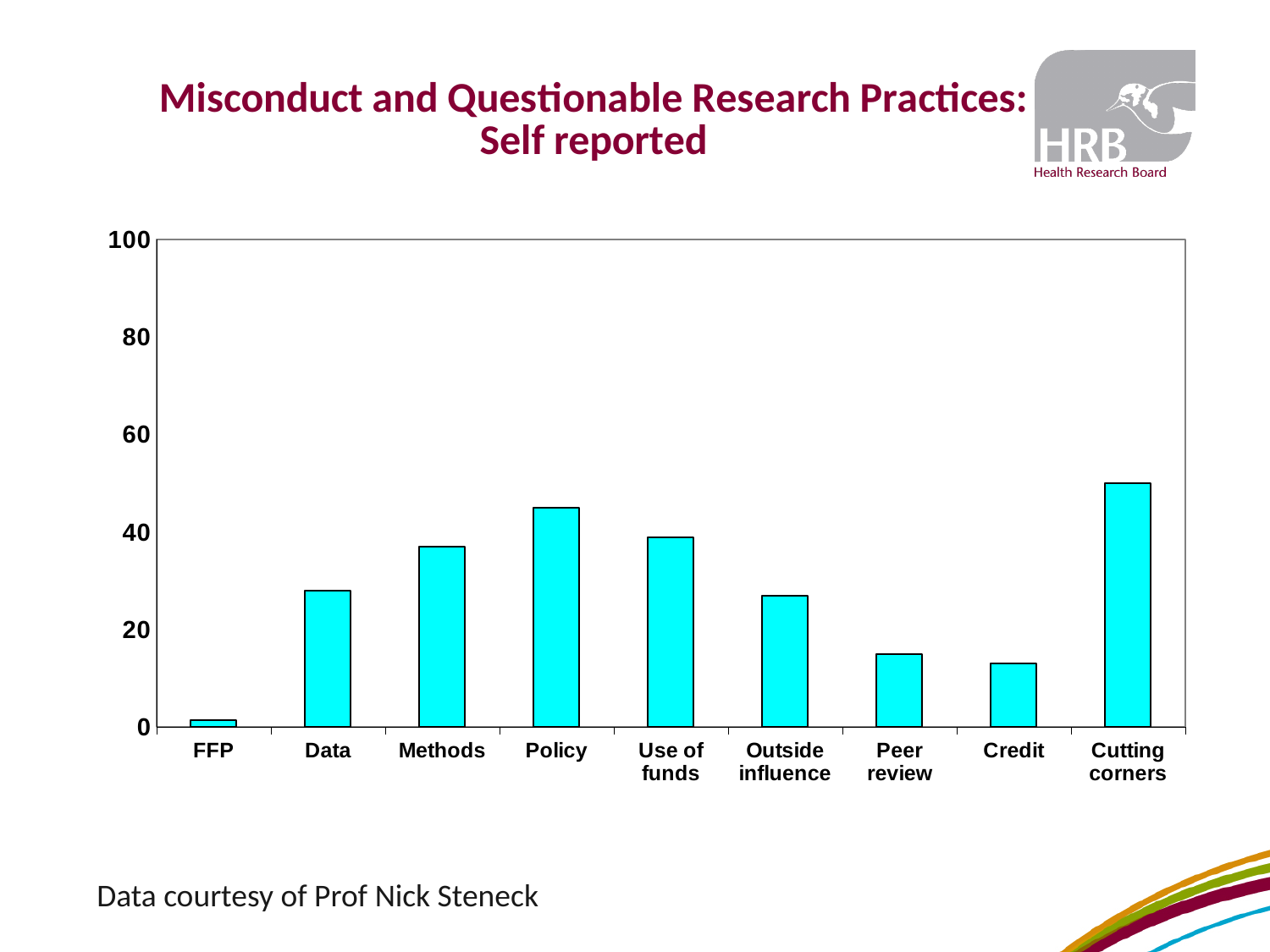
Is the value for Credit greater or less than 20? less What is the title of the slide containing the chart? Misconduct and Questionable Research Practices: Self reported Is the value for Data greater or less than 20? greater Is the value for Policy greater or less than 40? greater What is the highest value shown on the y axis? 100 Which is larger, the value for Policy or the value for Data? Policy Which category has the highest bar? Cutting corners Which is larger, the value for Methods or the value for Peer review? Methods How many categories are plotted on the x axis? 9 Which category has the lowest bar? FFP What kind of chart is shown on the slide? bar chart